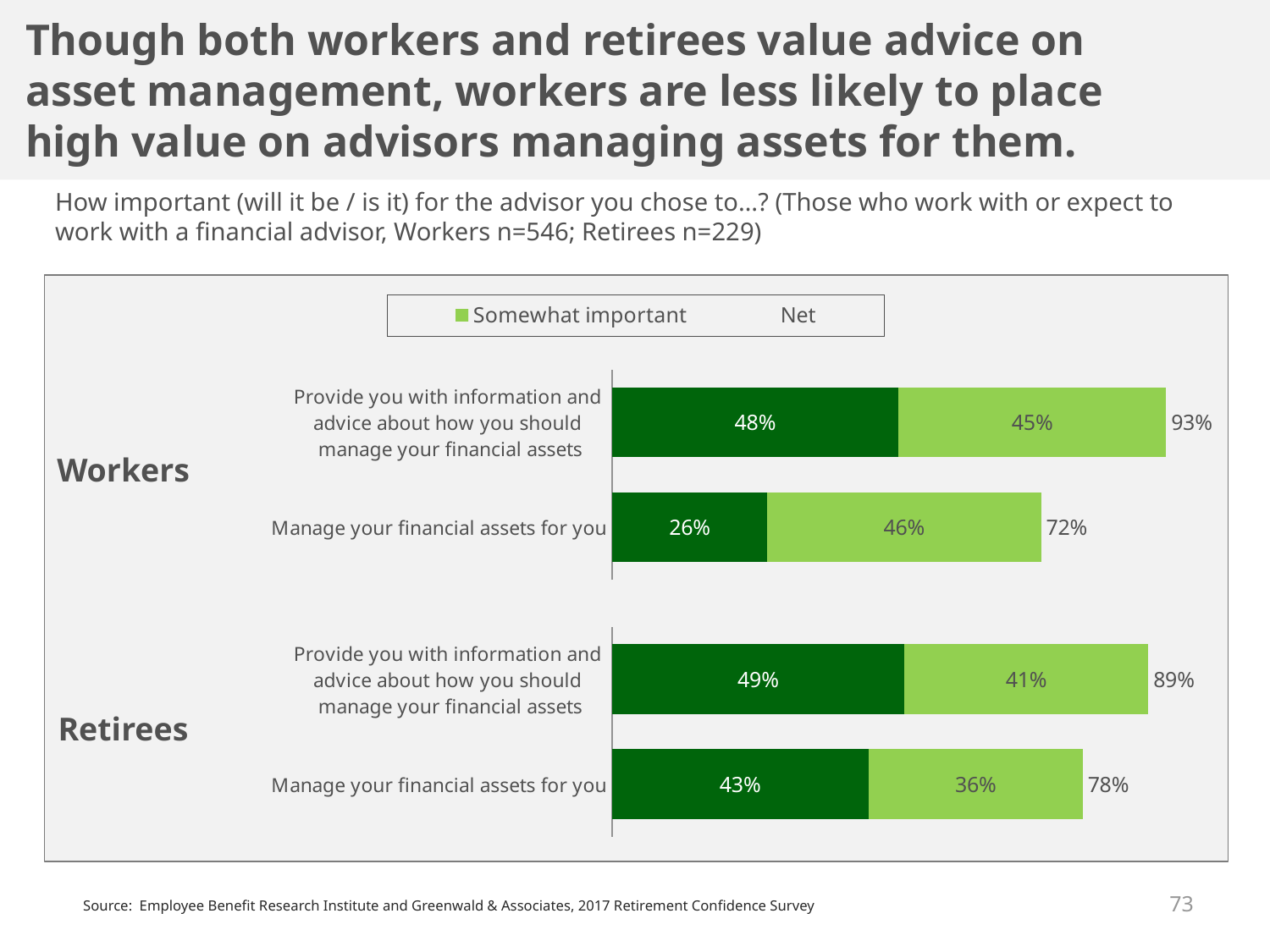
What is the Net value for Workers for "Manage your financial assets for you"? 72% What kind of chart is shown on the slide? Bar chart What is the "Somewhat important" value for Retirees for "Provide you with information and advice about how you should manage your financial assets"? 41% Which group and item has the lowest Net value? Workers, Manage your financial assets for you How many bars are plotted in the chart? 4 Which group and item has the highest Net value? Workers, Provide you with information and advice about how you should manage your financial assets For "Manage your financial assets for you", which group has the larger "Somewhat important" value, Workers or Retirees? Workers What is the "Somewhat important" value for Workers for "Provide you with information and advice about how you should manage your financial assets"? 45% For Workers, what is the difference in Net value between "Provide you with information and advice about how you should manage your financial assets" and "Manage your financial assets for you"? 21 percentage points How many entries does the chart legend list? 2 What is the Net value for Retirees for "Provide you with information and advice about how you should manage your financial assets"? 89% What is the difference in Net value between Retirees and Workers for "Manage your financial assets for you"? 6 percentage points